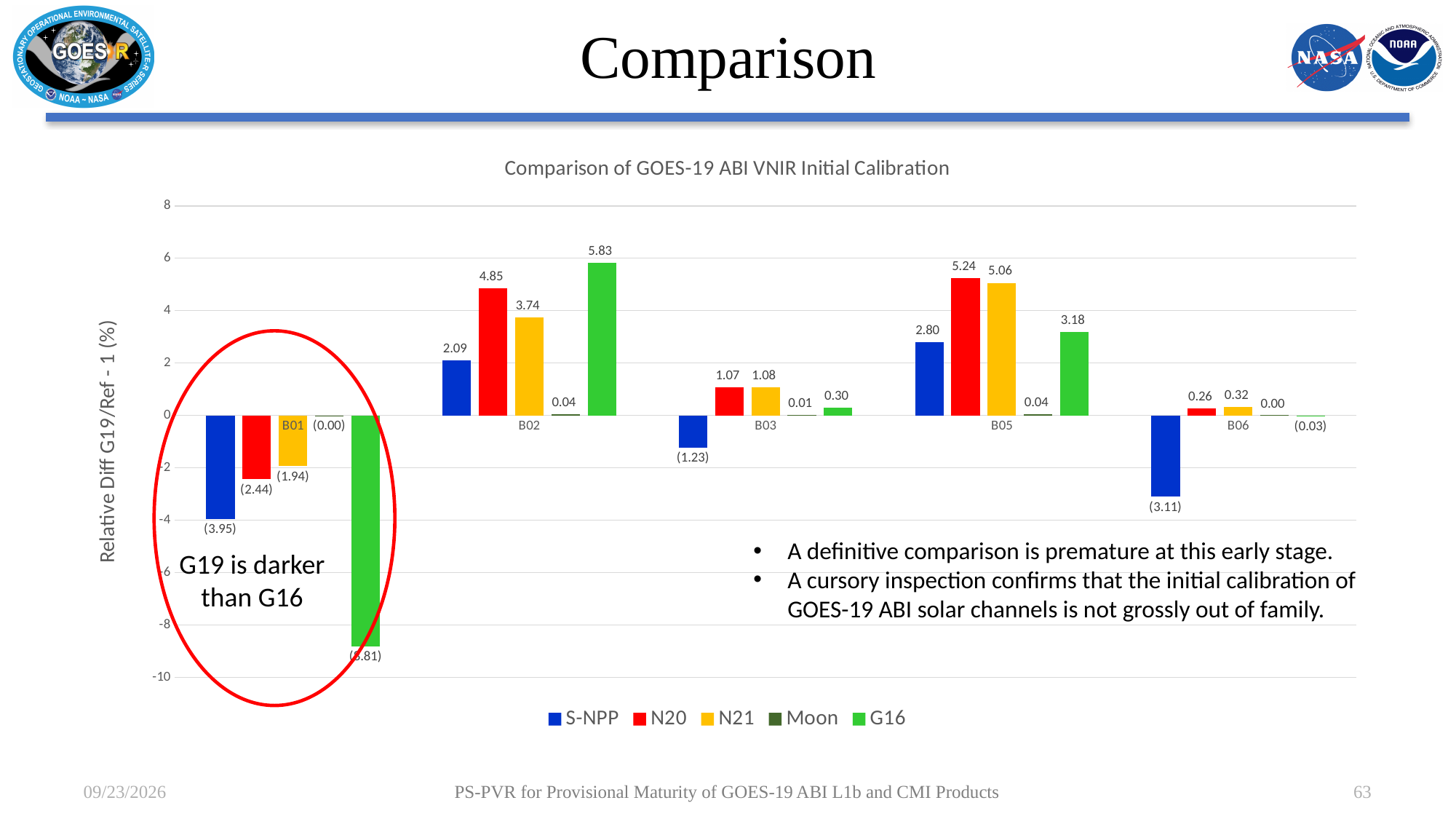
What is the value for S-NPP in category B01? (3.95) What is the difference between the N20 and N21 values in category B05? 0.18 What is the value for G16 in category B02? 5.83 What is the value for N20 in category B05? 5.24 Which series has the lowest value in category B06? S-NPP What kind of chart is shown on the slide? bar chart In category B02, which is larger, the N20 value or the N21 value? N20 Is the value for G16 in category B01 greater or less than -8? less What is the value for Moon in category B03? 0.01 How many categories are shown on the x axis? 5 How many series does the legend list? 5 Which series has the highest value in category B02? G16